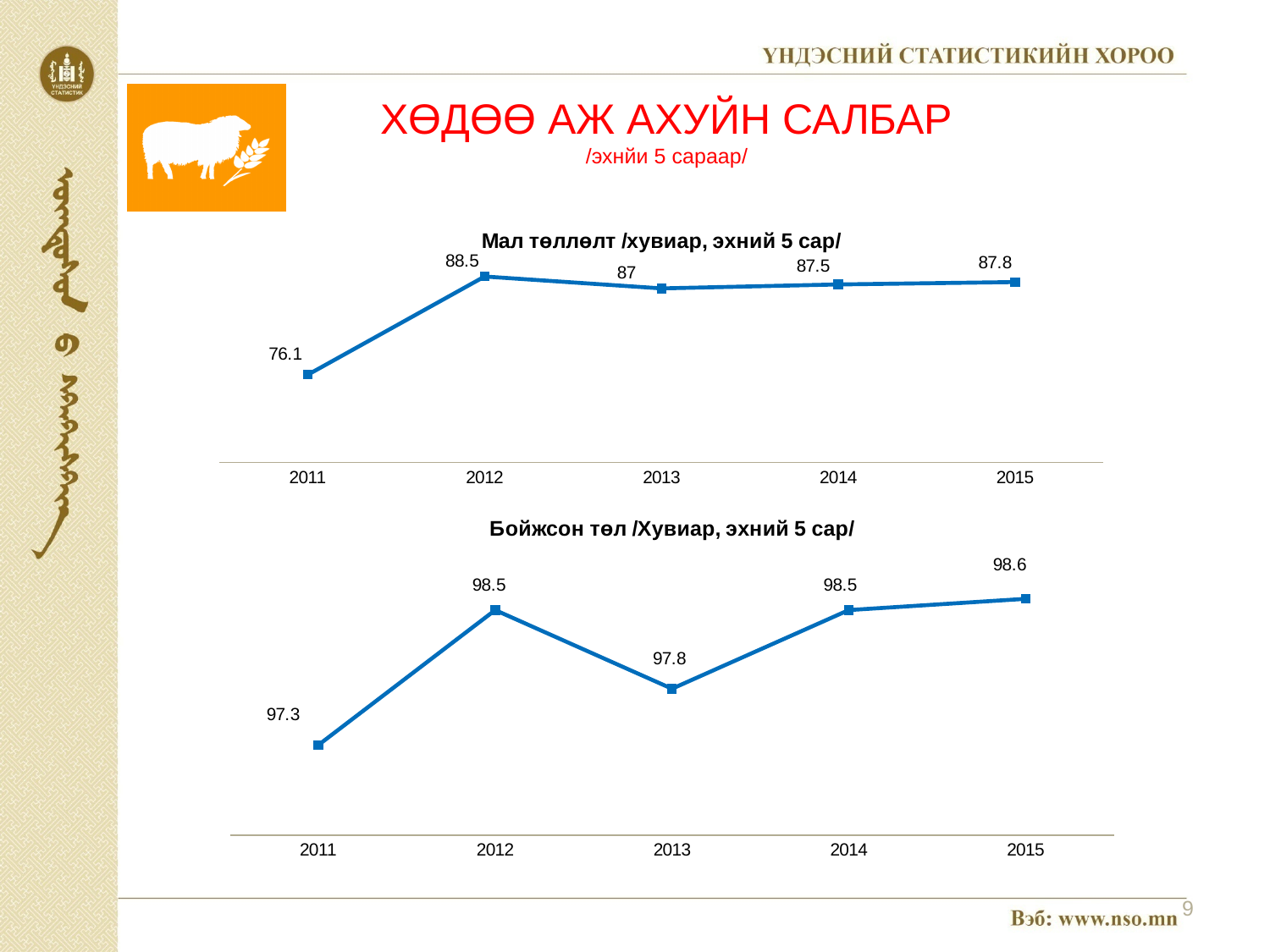
In the bottom chart (Бойжсон төл), what is the difference between the 2015 and 2011 values? 1.3 In the top chart (Мал төллөлт), what is the difference between the 2012 and 2011 values? 12.4 In the top chart (Мал төллөлт), which year has the highest value? 2012 In the bottom chart (Бойжсон төл), is the value for 2012 larger or smaller than the value for 2013? larger In the top chart (Мал төллөлт), how many years are plotted? 5 In the top chart (Мал төллөлт), which year has the lowest value? 2011 In the top chart (Мал төллөлт), what is the value for 2011? 76.1 In the bottom chart (Бойжсон төл), what is the value for 2015? 98.6 In the bottom chart (Бойжсон төл), which year has the lowest value? 2011 In the bottom chart (Бойжсон төл), what is the value for 2013? 97.8 In the top chart (Мал төллөлт), what is the value for 2013? 87 What type of chart is the bottom chart (Бойжсон төл)? line chart